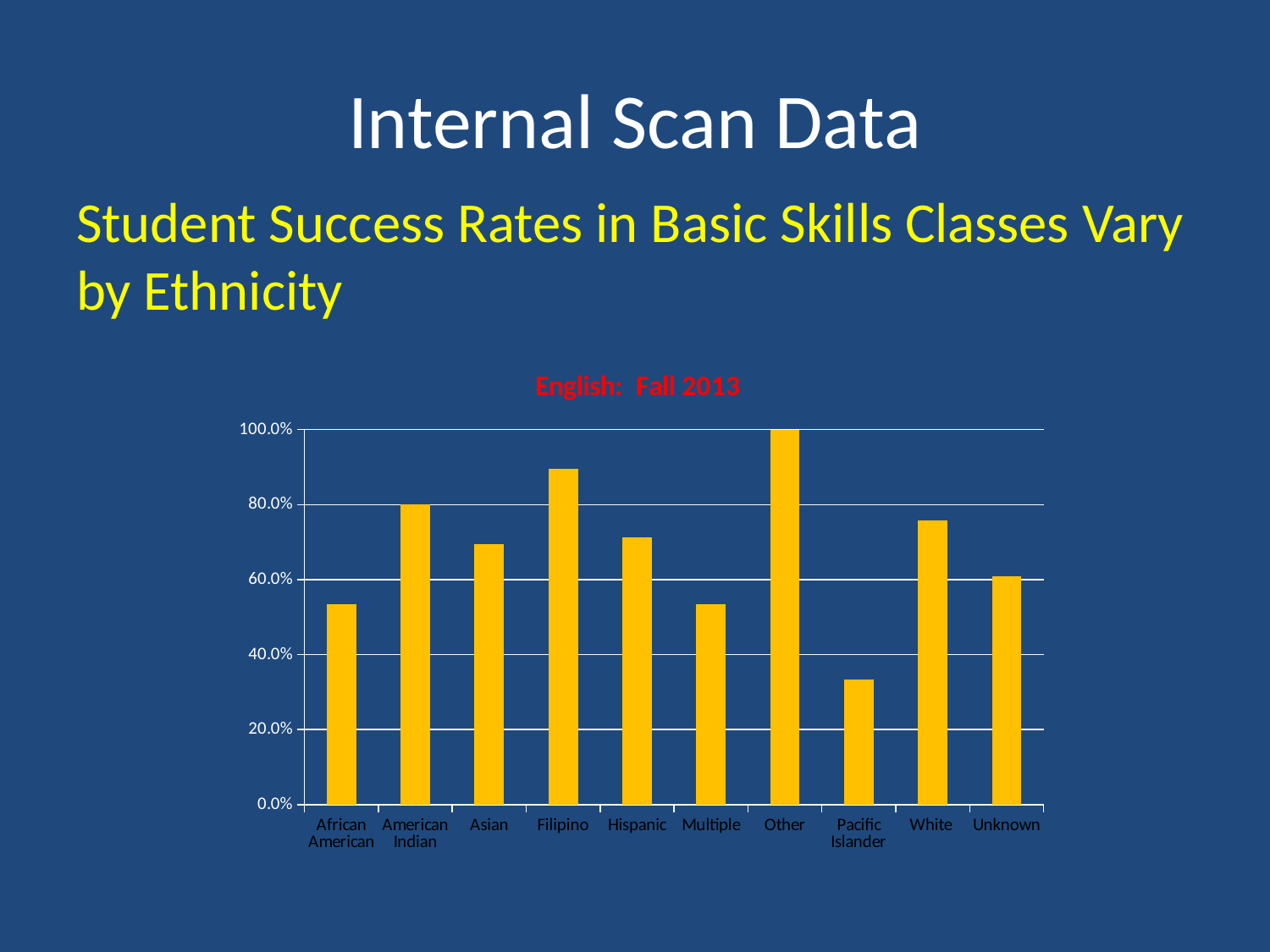
What kind of chart is shown on the slide? bar chart What is the success rate for the Other category? 100.0% Is the value for Filipino greater or less than 80.0%? greater Which has a higher success rate, Filipino or Asian? Filipino Is the value for African American greater or less than 60.0%? less Is the value for Pacific Islander greater or less than 40.0%? less What is the title of the chart? English: Fall 2013 Which ethnicity category has the highest success rate in the chart? Other How many ethnicity categories are shown on the x axis of the chart? 10 Which has a higher success rate, Hispanic or Multiple? Hispanic Which ethnicity category has the lowest success rate in the chart? Pacific Islander